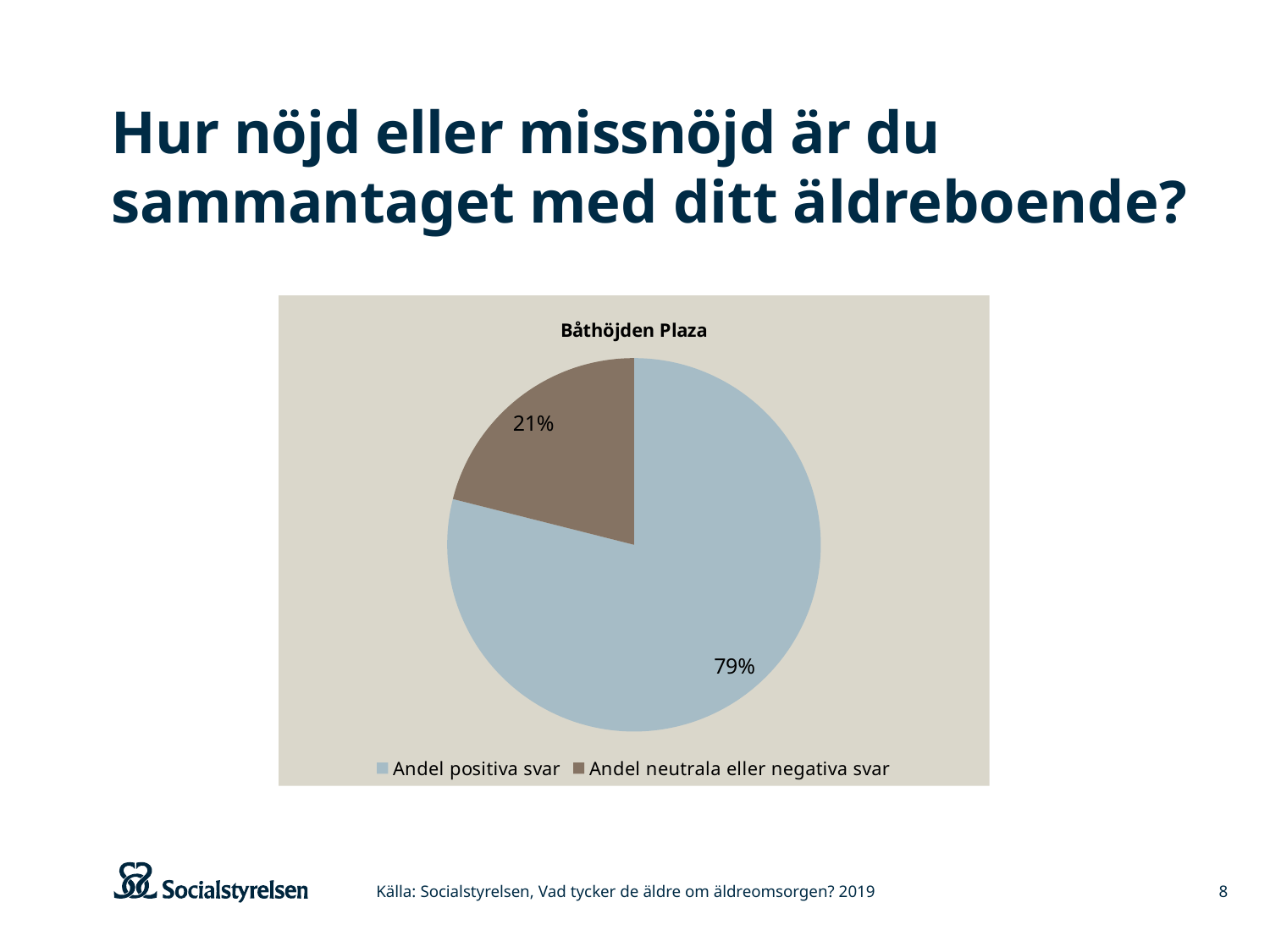
How many entries does the legend list? 2 What share of the pie is 'Andel neutrala eller negativa svar'? 21% What type of chart is shown on the slide? pie chart What is the title of the chart? Båthöjden Plaza Which slice is the smallest in the pie chart? Andel neutrala eller negativa svar What colour is the 'Andel neutrala eller negativa svar' slice? brown How many slices does the pie chart have? 2 Which is larger, 'Andel positiva svar' or 'Andel neutrala eller negativa svar'? Andel positiva svar Which slice is the largest in the pie chart? Andel positiva svar What is the difference in percentage points between 'Andel positiva svar' and 'Andel neutrala eller negativa svar'? 58 What share of the pie is 'Andel positiva svar'? 79%